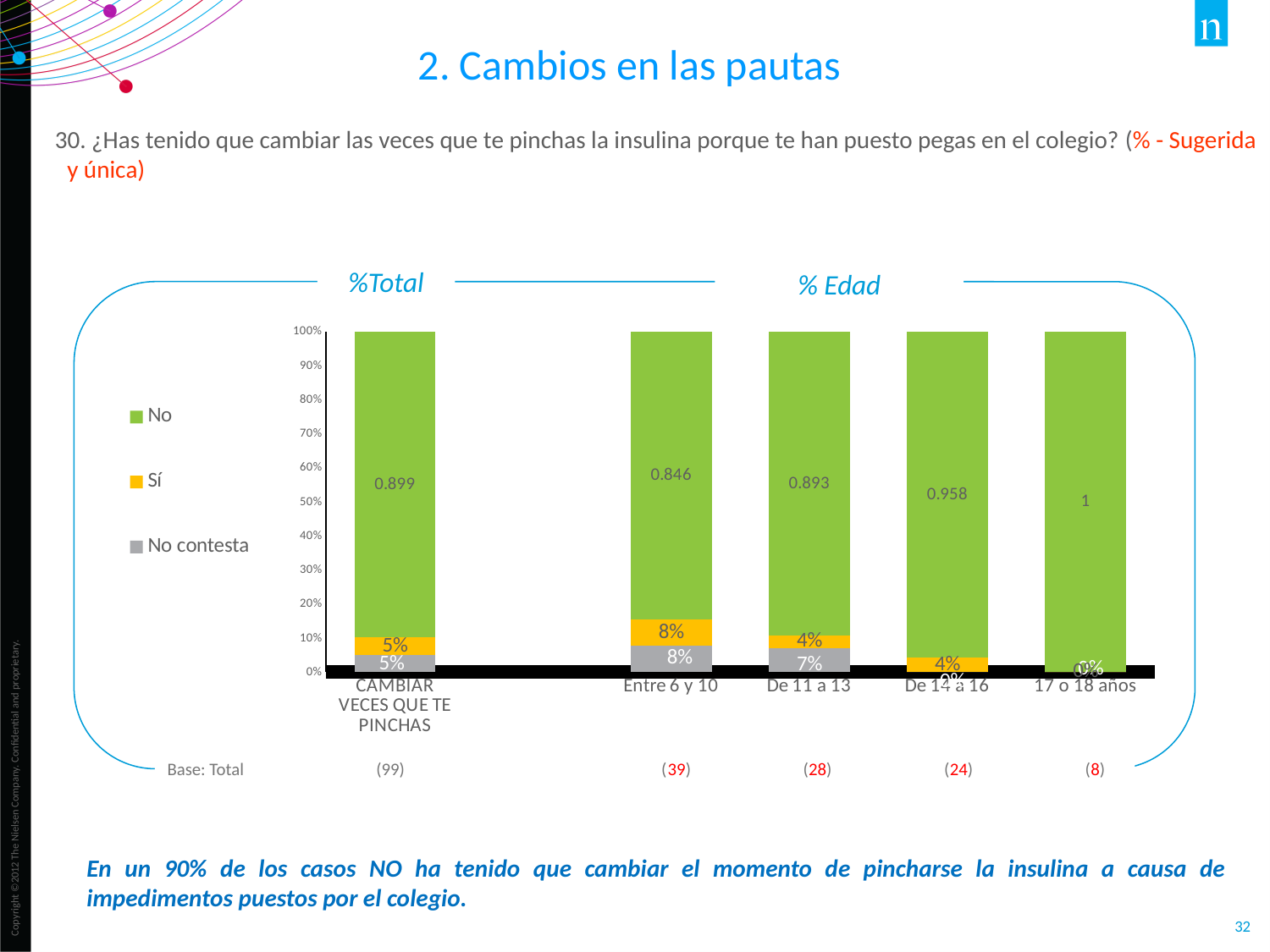
Which series is shown in green in the chart? No What is the value of the 'No' series for the 'De 14 a 16' category? 0.958 What is the value of the 'No' series for the '17 o 18 años' category? 1 What is the value of the 'No contesta' series for the 'De 11 a 13' category? 7% What is the value of the 'Sí' series for the 'Entre 6 y 10' category? 8% Which category has the lowest value for the 'No' series? Entre 6 y 10 What type of chart is shown on the slide? stacked bar chart Which category has the highest value for the 'No' series? 17 o 18 años How many series does the chart legend list? 3 How many categories are plotted along the x axis of the chart? 5 What is the value of the 'No' series for the 'Entre 6 y 10' category? 0.846 Is the 'Sí' value for 'Entre 6 y 10' larger or smaller than the 'Sí' value for 'De 11 a 13'? larger